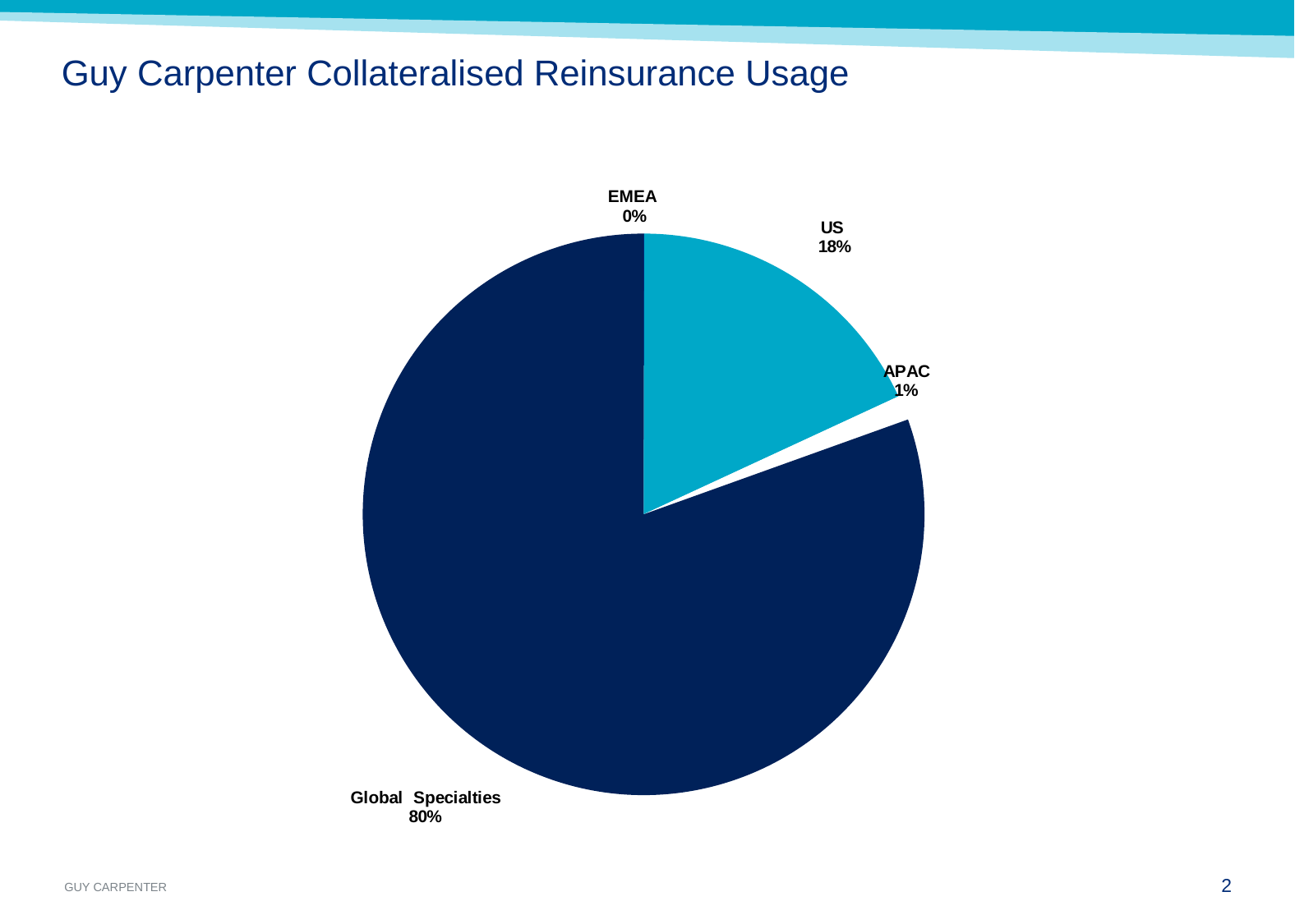
What is the title of the slide? Guy Carpenter Collateralised Reinsurance Usage Which category has the smallest slice of the pie? EMEA What share of the pie does APAC hold? 1% What is the difference in percentage points between Global Specialties and US? 62 What kind of chart is shown on the slide? Pie chart How many categories are shown in the pie chart? 4 Which is larger, the US slice or the APAC slice? US What share of the pie does EMEA hold? 0% What share of the pie does Global Specialties hold? 80% What share of the pie does US hold? 18% What is the difference in percentage points between US and APAC? 17 Which category has the largest slice of the pie? Global Specialties